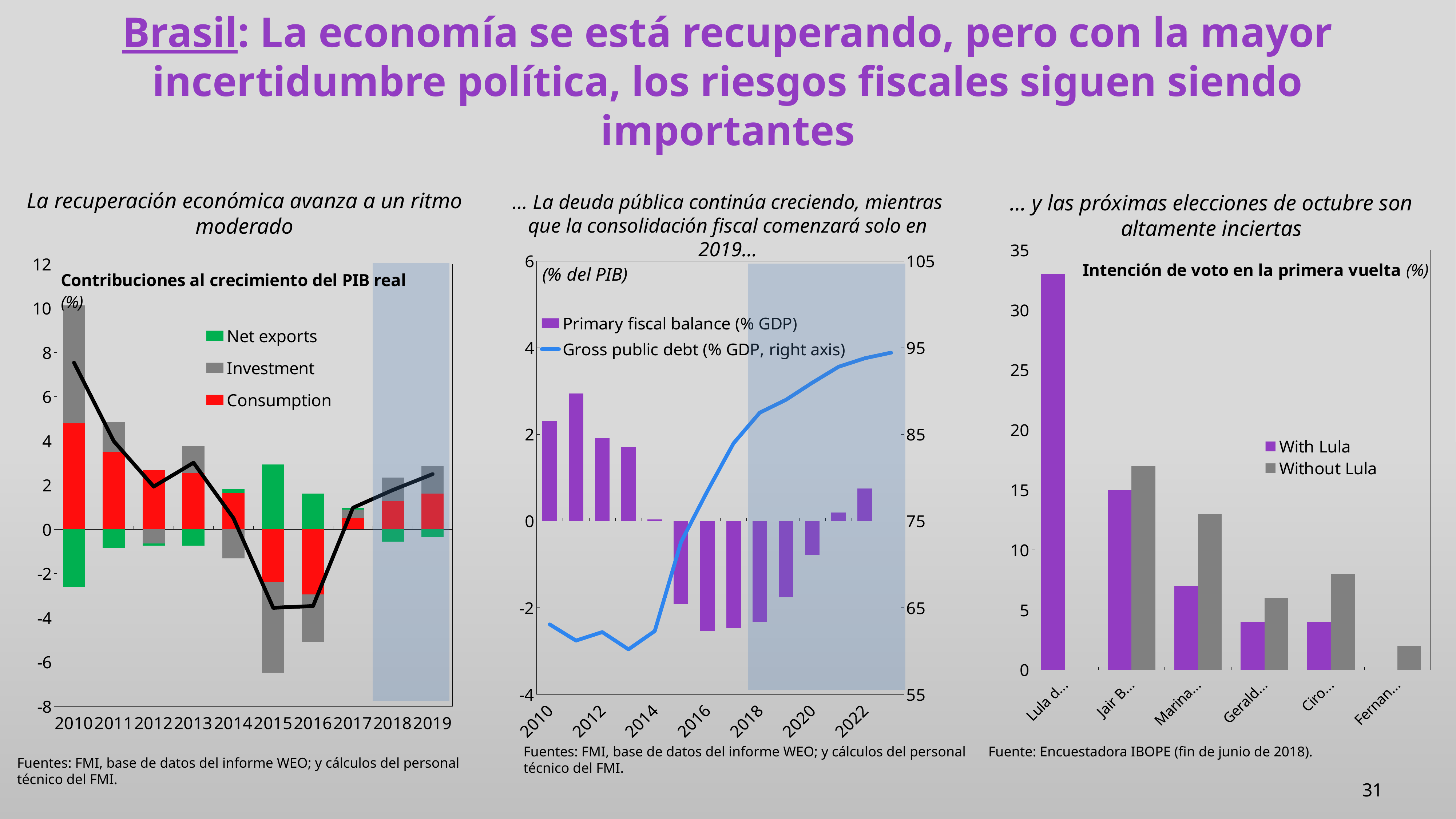
In the right chart (Intención de voto en la primera vuelta), which candidate has the highest 'With Lula' bar? Lula d... In the right chart (Intención de voto en la primera vuelta), what kind of chart is it? bar chart In the middle chart, is the Gross public debt (% GDP, right axis) value for 2022 greater or less than 85? greater In the right chart (Intención de voto en la primera vuelta), how many candidates are shown on the x axis? 6 In the middle chart, is the Primary fiscal balance (% GDP) value for 2016 greater or less than -2? less In the left chart (Contribuciones al crecimiento del PIB real), how many series does the legend list? 3 In the middle chart, how many series does the legend list? 2 In the left chart (Contribuciones al crecimiento del PIB real), how many years are shown on the x axis? 10 In the left chart (Contribuciones al crecimiento del PIB real), which colour represents Consumption in the legend? red In the right chart (Intención de voto en la primera vuelta), is the 'With Lula' value for Lula d... greater or less than 30? greater In the right chart (Intención de voto en la primera vuelta), how many series does the legend list? 2 In the right chart (Intención de voto en la primera vuelta), which is larger: the 'Without Lula' value for Jair B... or for Marina...? Jair B...